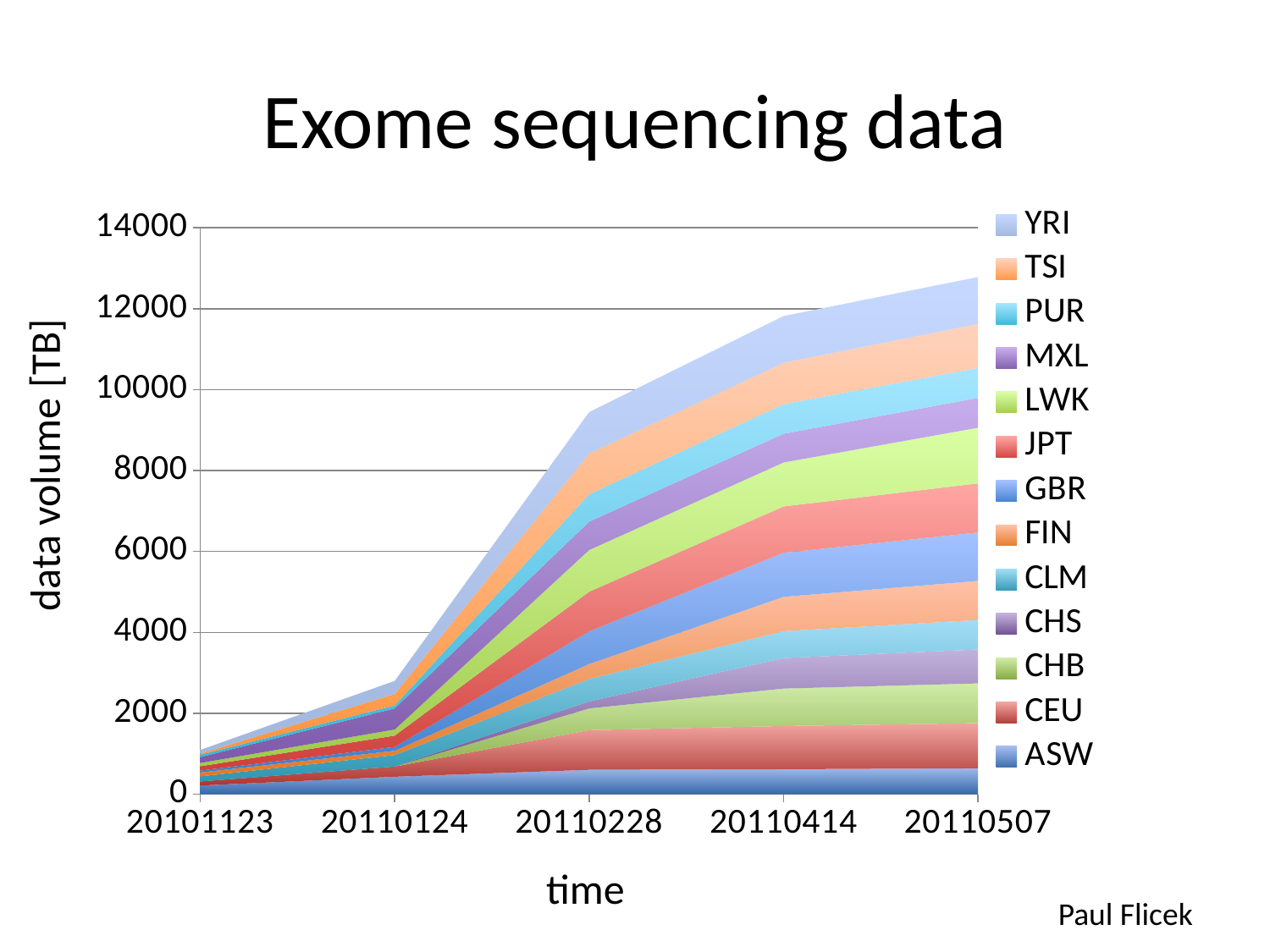
What kind of chart is shown on the slide? stacked area chart How many series does the legend list? 13 What is the title of the chart? Exome sequencing data Is the total data volume at 20110228 greater or less than 8000? greater Is the total data volume at 20110124 greater or less than 4000? less What is the label of the y axis? data volume [TB] Is the total data volume at 20110507 greater or less than 12000? greater Does the total data volume rise or fall over time along the x axis? rise How many time points are plotted along the x axis? 5